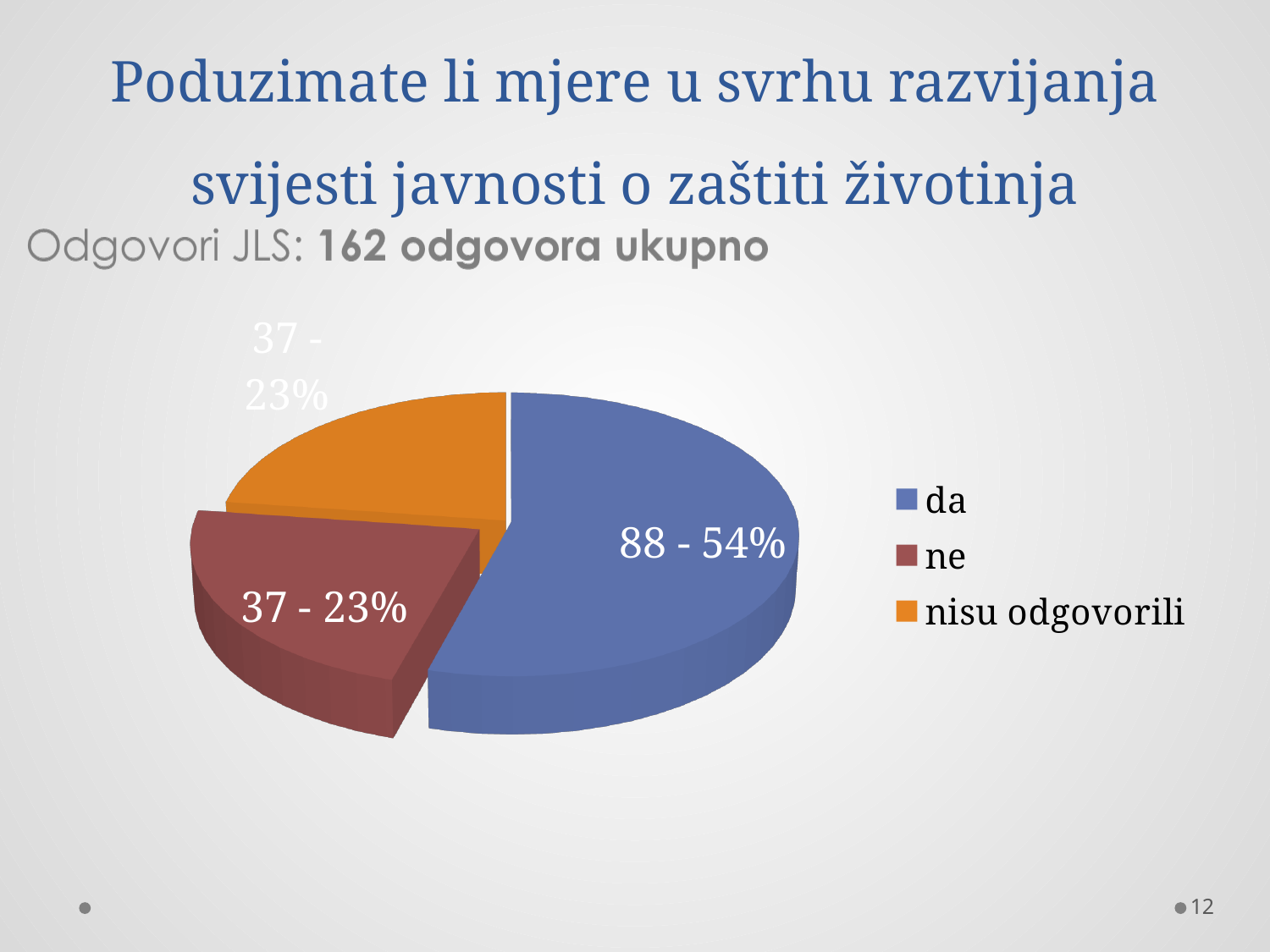
What colour is the "nisu odgovorili" slice? orange What is the data label for the "ne" slice? 37 - 23% What is the data label for the "nisu odgovorili" slice? 37 - 23% How many entries does the legend list? 3 What share of the pie does the "ne" slice represent? 23% How many more responses are there for "da" than for "ne"? 51 What is the data label for the "da" slice? 88 - 54% How many slices does the pie chart have? 3 What kind of chart is shown on the slide? pie chart What share of the pie does the "da" slice represent? 54% Which category has the largest slice of the pie? da Which is larger, the "da" slice or the "nisu odgovorili" slice? da